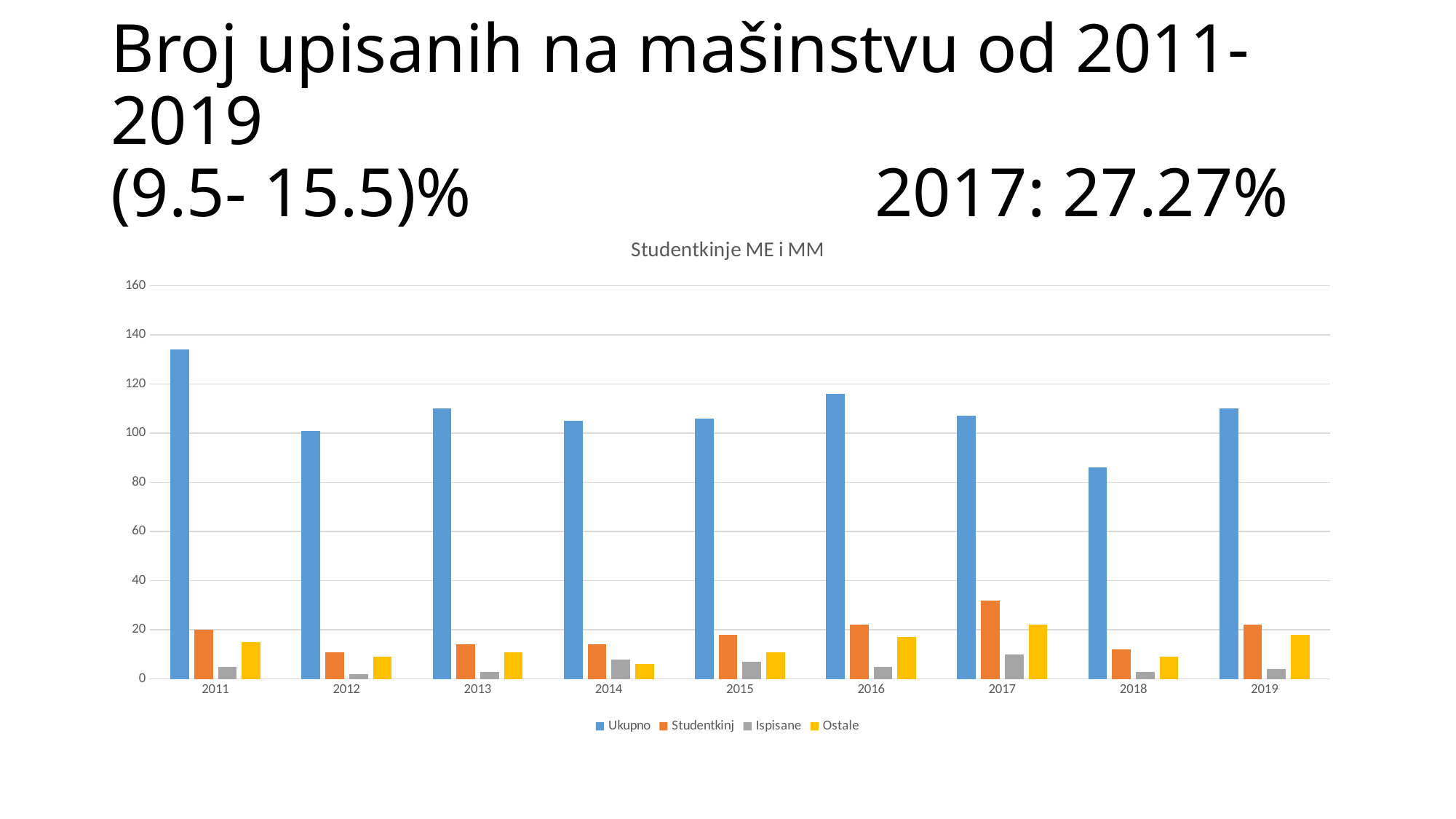
What type of chart is shown on the slide? bar chart Which year has the larger Studentkinj value, 2012 or 2017? 2017 In which year is the Studentkinj value highest? 2017 In which year is the Ukupno value highest? 2011 Is the Ukupno value for 2018 greater or less than 100? less In which year is the Ostale value highest? 2017 Is the Ukupno value for 2011 greater or less than 120? greater How many years are shown on the x axis of the chart? 9 Is the Studentkinj value for 2017 greater or less than 20? greater In which year is the Ukupno value lowest? 2018 What is the title of the chart? Studentkinje ME i MM How many series does the legend list? 4